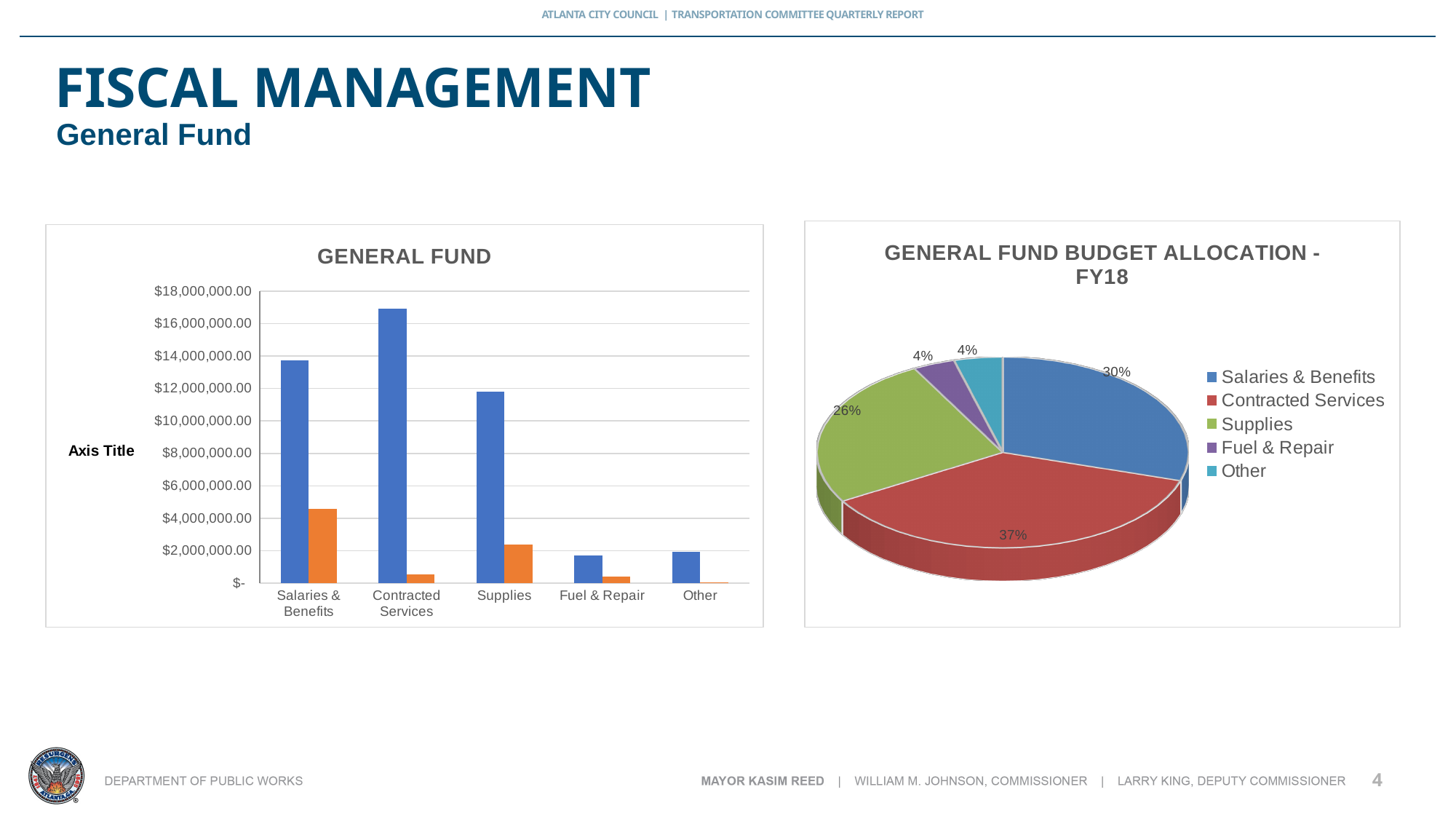
In the GENERAL FUND bar chart, which has the taller blue bar, Salaries & Benefits or Supplies? Salaries & Benefits In the GENERAL FUND bar chart, which category has the tallest blue bar? Contracted Services What kind of chart is the GENERAL FUND chart on the left? bar chart In the GENERAL FUND BUDGET ALLOCATION - FY18 pie chart, how many percentage points larger is Contracted Services than Salaries & Benefits? 7 In the GENERAL FUND bar chart, is the blue bar for Contracted Services greater or less than $16,000,000.00? greater In the GENERAL FUND bar chart, how many categories are on the x axis? 5 In the GENERAL FUND BUDGET ALLOCATION - FY18 pie chart, what share is Contracted Services? 37% In the GENERAL FUND BUDGET ALLOCATION - FY18 pie chart, which category has the largest slice? Contracted Services In the GENERAL FUND BUDGET ALLOCATION - FY18 pie chart, what share is Fuel & Repair? 4% In the GENERAL FUND BUDGET ALLOCATION - FY18 pie chart, what share is Supplies? 26% In the GENERAL FUND bar chart, is the orange bar for Salaries & Benefits greater or less than $4,000,000.00? greater In the GENERAL FUND BUDGET ALLOCATION - FY18 pie chart, how many categories are shown? 5